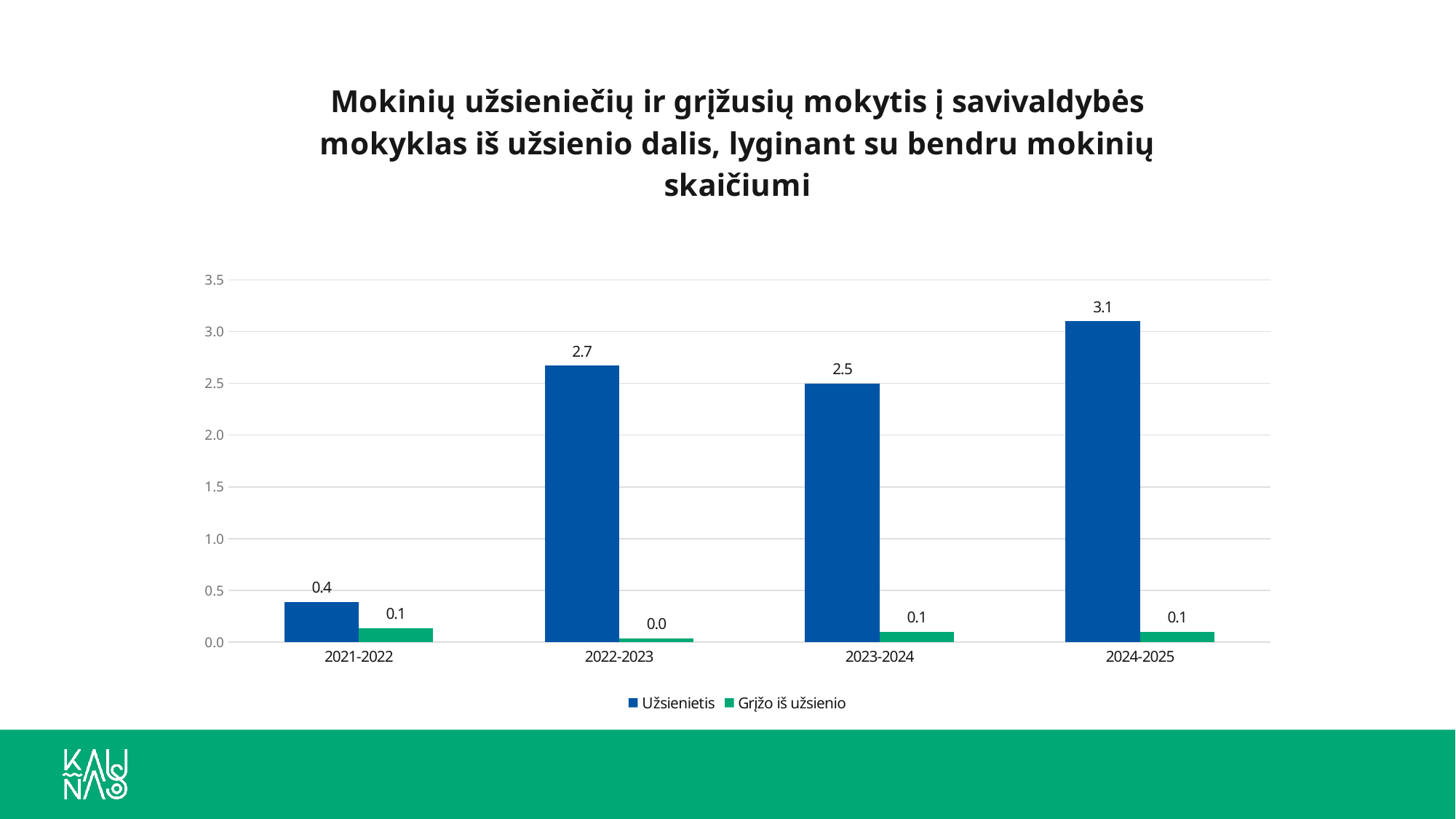
What is the value for Grįžo iš užsienio in 2023-2024? 0.1 What is the value for Grįžo iš užsienio in 2022-2023? 0.0 What kind of chart is shown on the slide? bar chart Is the Užsienietis value for 2024-2025 greater or less than 3.0? greater Which is larger, the Užsienietis value for 2022-2023 or for 2023-2024? 2022-2023 What is the value for Užsienietis in 2021-2022? 0.4 What is the difference between the Užsienietis values for 2024-2025 and 2022-2023? 0.4 What is the value for Užsienietis in 2024-2025? 3.1 In which school year is the Užsienietis value lowest? 2021-2022 How many school years are shown on the x axis? 4 In which school year is the Užsienietis value highest? 2024-2025 How many series does the legend list? 2